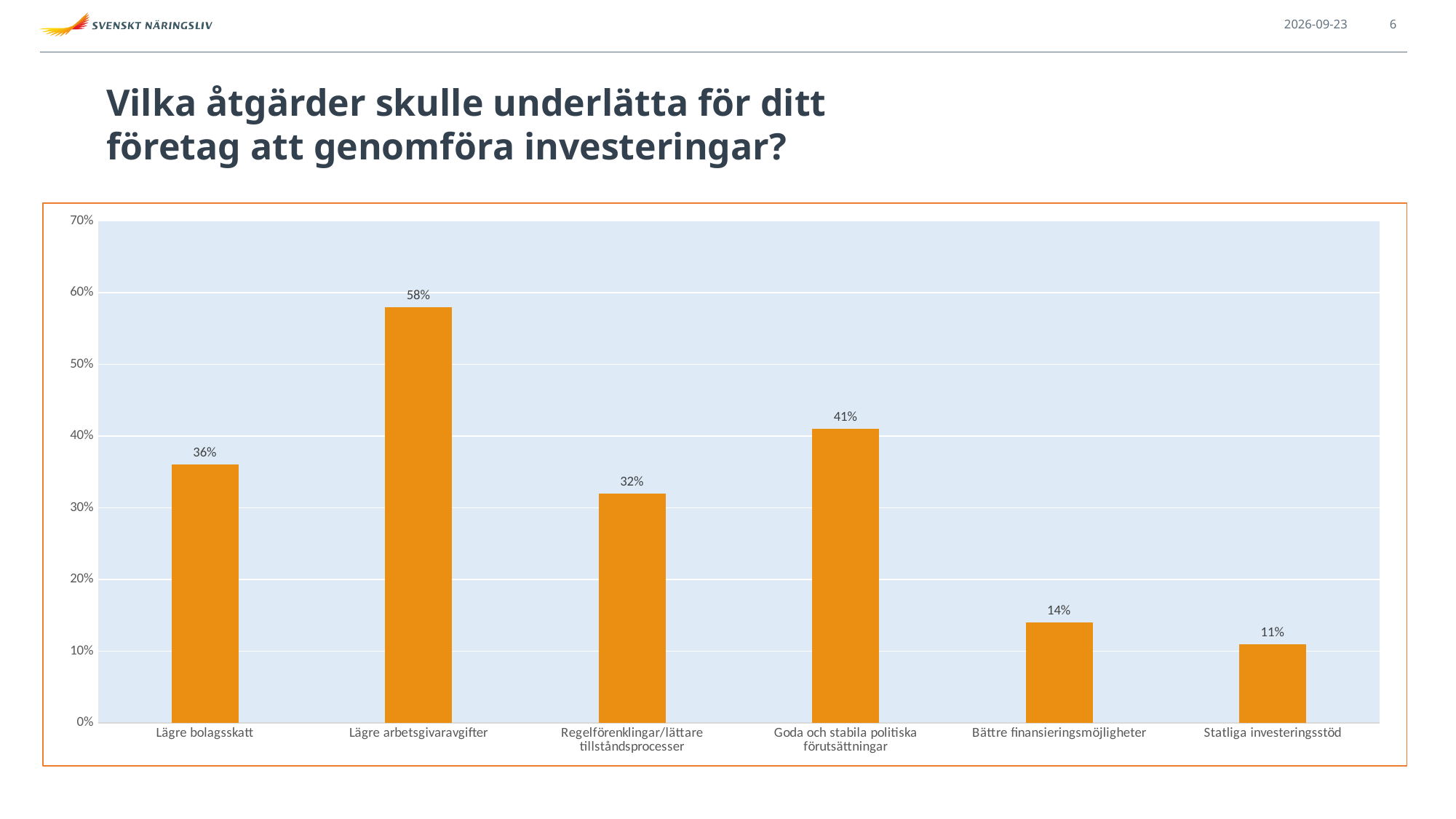
How many categories are shown in the chart? 6 What is the value for Lägre arbetsgivaravgifter? 58% What is the value for Lägre bolagsskatt? 36% Which category has the lowest value? Statliga investeringsstöd Which is larger, the value for Lägre bolagsskatt or the value for Regelförenklingar/lättare tillståndsprocesser? Lägre bolagsskatt What is the value for Statliga investeringsstöd? 11% What is the difference between the values for Lägre arbetsgivaravgifter and Goda och stabila politiska förutsättningar? 17% What is the highest value shown on the vertical axis? 70% Is the value for Bättre finansieringsmöjligheter greater or less than 20%? less What is the value for Regelförenklingar/lättare tillståndsprocesser? 32% Which category has the highest value? Lägre arbetsgivaravgifter What kind of chart is shown on the slide? bar chart